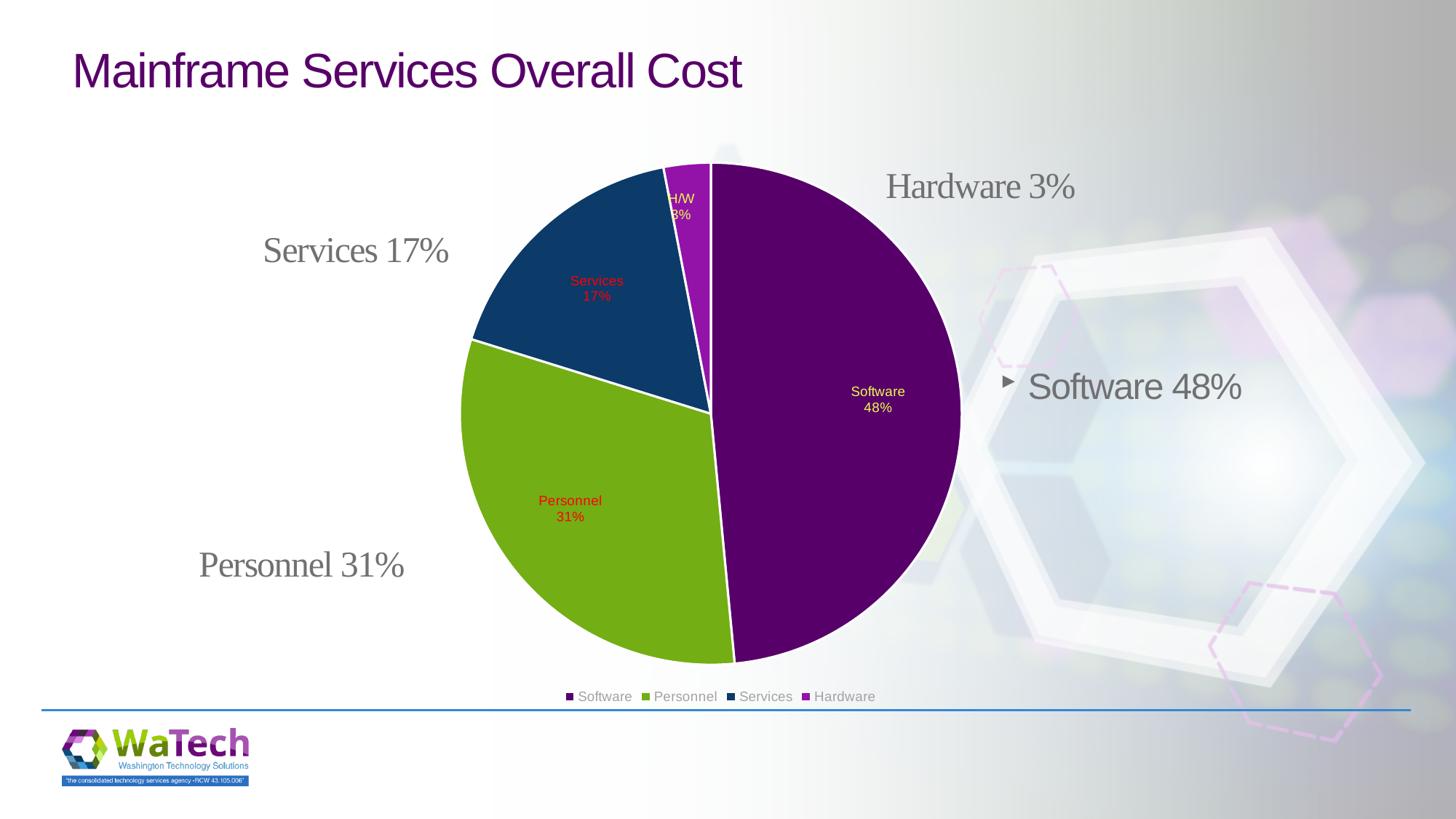
What share of the pie does Services account for? 17% Which category has the largest slice of the pie? Software How many categories does the pie chart have? 4 What is the difference in percentage points between Software and Personnel? 17 Which is larger, the Personnel slice or the Services slice? Personnel What type of chart is shown on the slide? pie chart Which category has the smallest slice of the pie? Hardware What share of the pie does Hardware account for? 3% What share of the pie does Personnel account for? 31% What is the difference in percentage points between Services and Hardware? 14 What is the title of the slide containing the pie chart? Mainframe Services Overall Cost